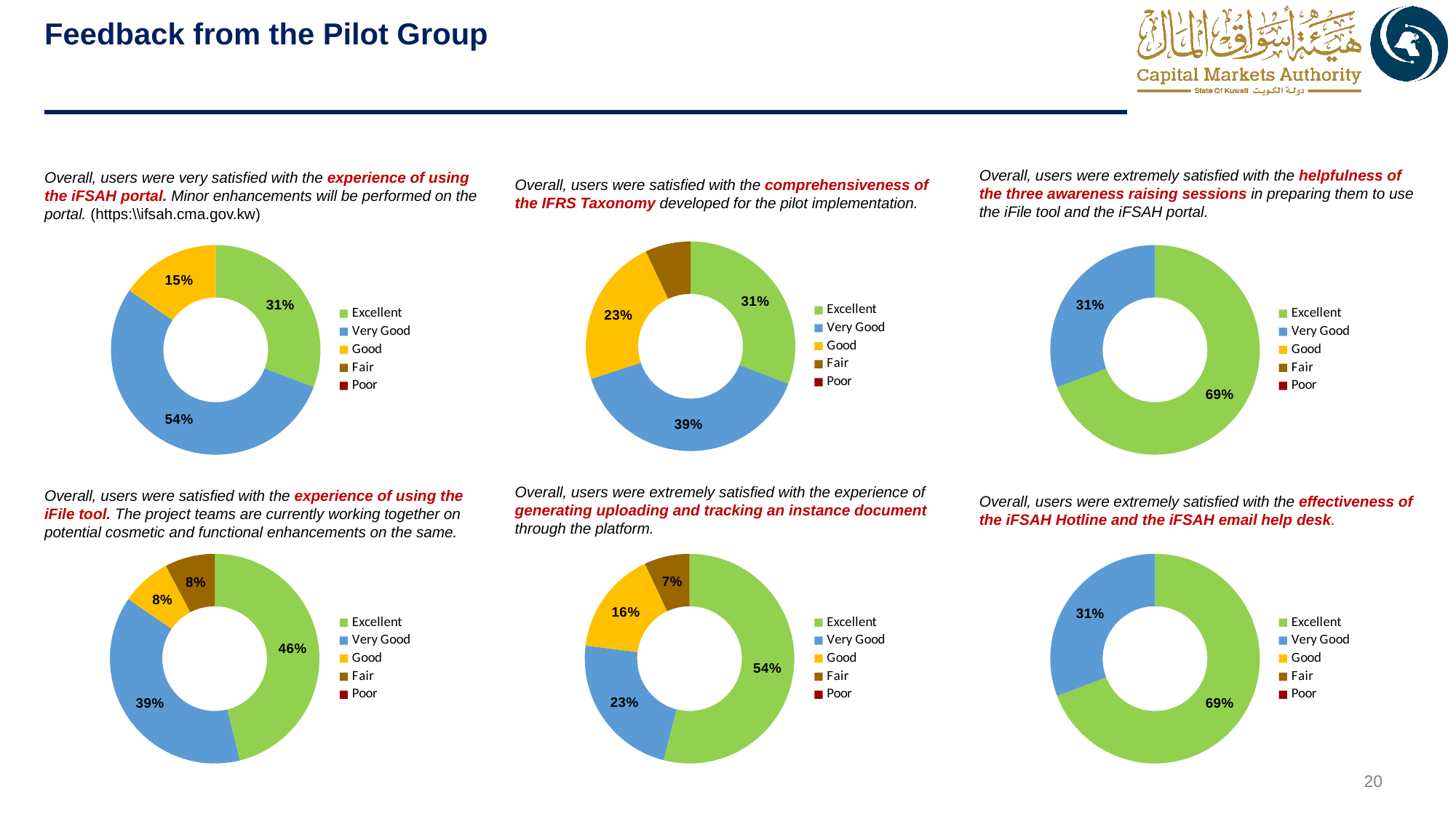
In the top-left chart (experience of using the iFSAH portal), what percentage of users rated it Very Good? 54% In the bottom-left chart (experience of using the iFile tool), what percentage of users rated it Excellent? 46% How many rating categories does the legend of the bottom-right chart list? 5 In the bottom-middle chart (generating, uploading and tracking an instance document), which is larger, the Very Good share or the Good share? Very Good In the top-right chart (helpfulness of the three awareness raising sessions), what is the difference between the Excellent and Very Good shares? 38% In the top-middle chart (comprehensiveness of the IFRS Taxonomy), which rating has the largest share? Very Good In the bottom-right chart (effectiveness of the iFSAH Hotline and email help desk), what percentage of users rated it Very Good? 31% In the top-middle chart (comprehensiveness of the IFRS Taxonomy), what percentage of users rated it Good? 23% In the bottom-middle chart (generating, uploading and tracking an instance document), what percentage of users rated it Fair? 7% In the top-right chart (helpfulness of the three awareness raising sessions), what percentage of users rated them Excellent? 69% In the bottom-left chart (experience of using the iFile tool), what is the difference between the Excellent and Very Good shares? 7%